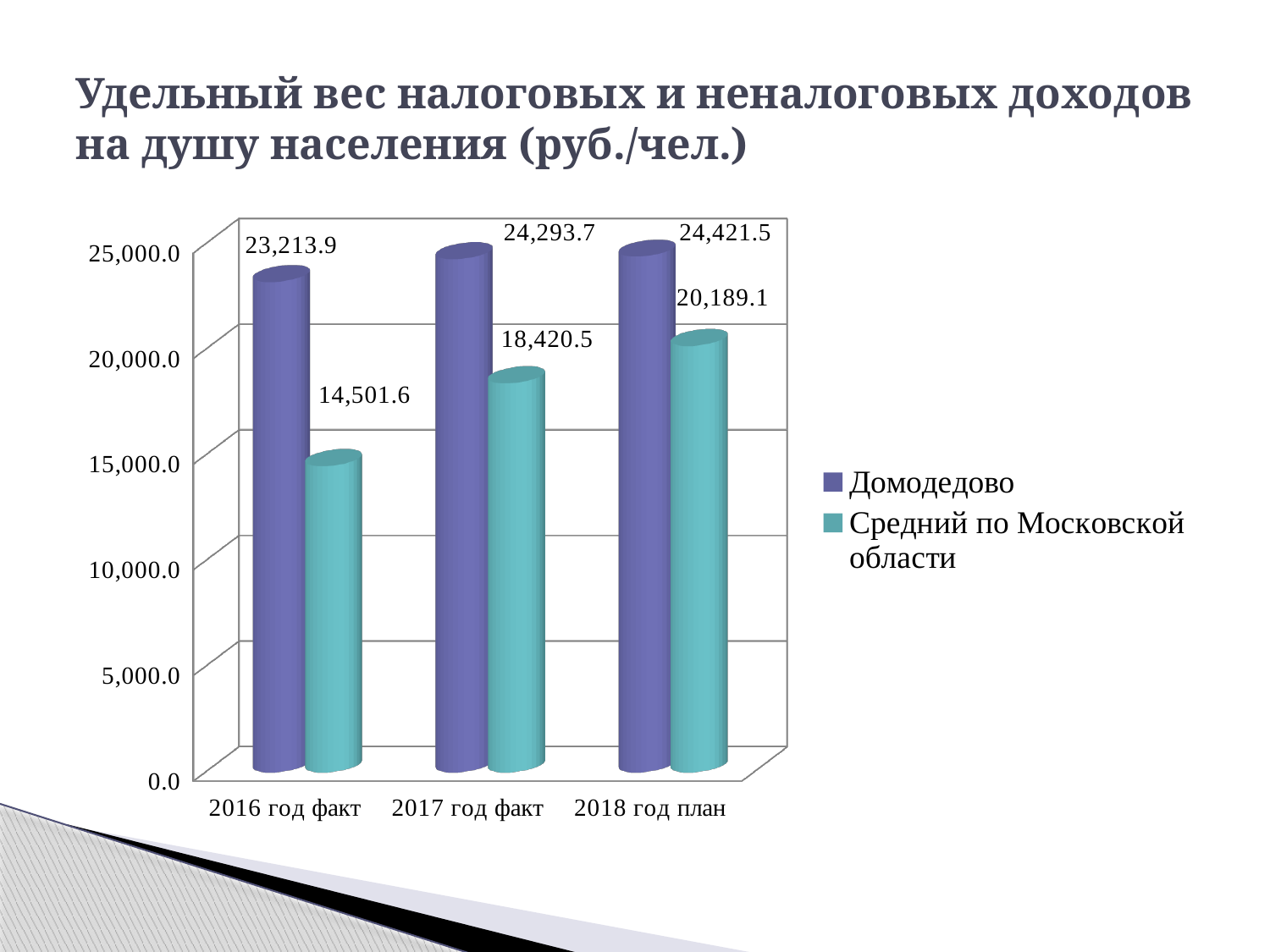
What is the difference between Домодедово and Средний по Московской области in 2018 год план? 4,232.4 Do the values for Средний по Московской области rise or fall from 2016 год факт to 2018 год план? Rise What type of chart is shown on the slide? Bar chart How many categories are shown on the x axis? 3 In which category is the value for Средний по Московской области the lowest? 2016 год факт Which is larger in 2017 год факт: Домодедово or Средний по Московской области? Домодедово How many series does the legend list? 2 What is the value for Средний по Московской области in 2018 год план? 20,189.1 What is the value for Средний по Московской области in 2017 год факт? 18,420.5 What is the difference between Домодедово and Средний по Московской области in 2016 год факт? 8,712.3 What is the value for Домодедово in 2016 год факт? 23,213.9 In which category is the value for Домодедово the highest? 2018 год план